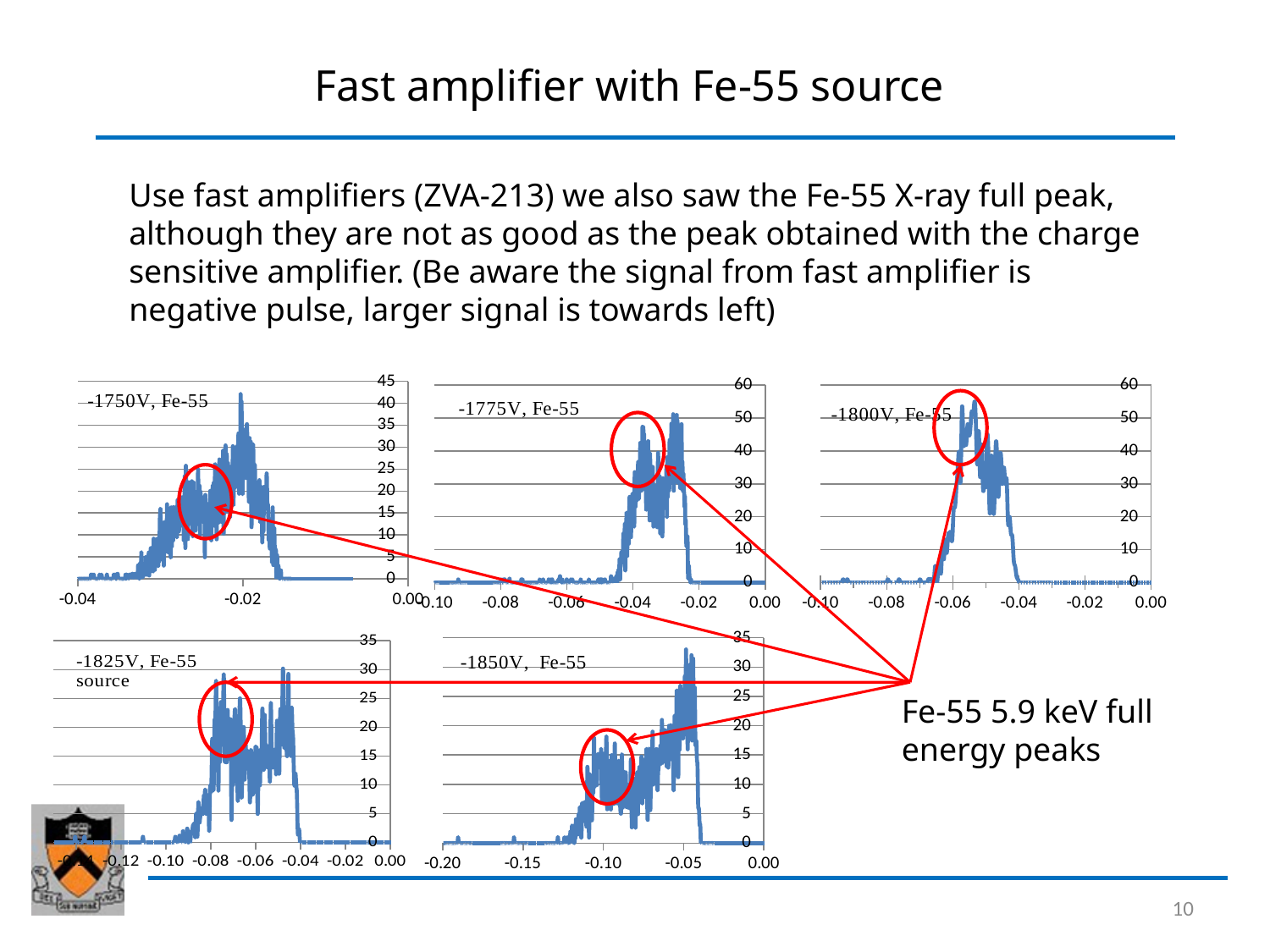
In the -1850V, Fe-55 chart, is the highest peak greater or less than 25? greater In the -1750V, Fe-55 chart, is the highest peak greater or less than 45? less In the -1775V, Fe-55 chart, is the highest peak greater or less than 40? greater What do the red circles on the charts mark, according to the annotation on the slide? Fe-55 5.9 keV full energy peaks What kind of chart is the -1750V, Fe-55 chart? line chart How many charts are shown on the slide? 5